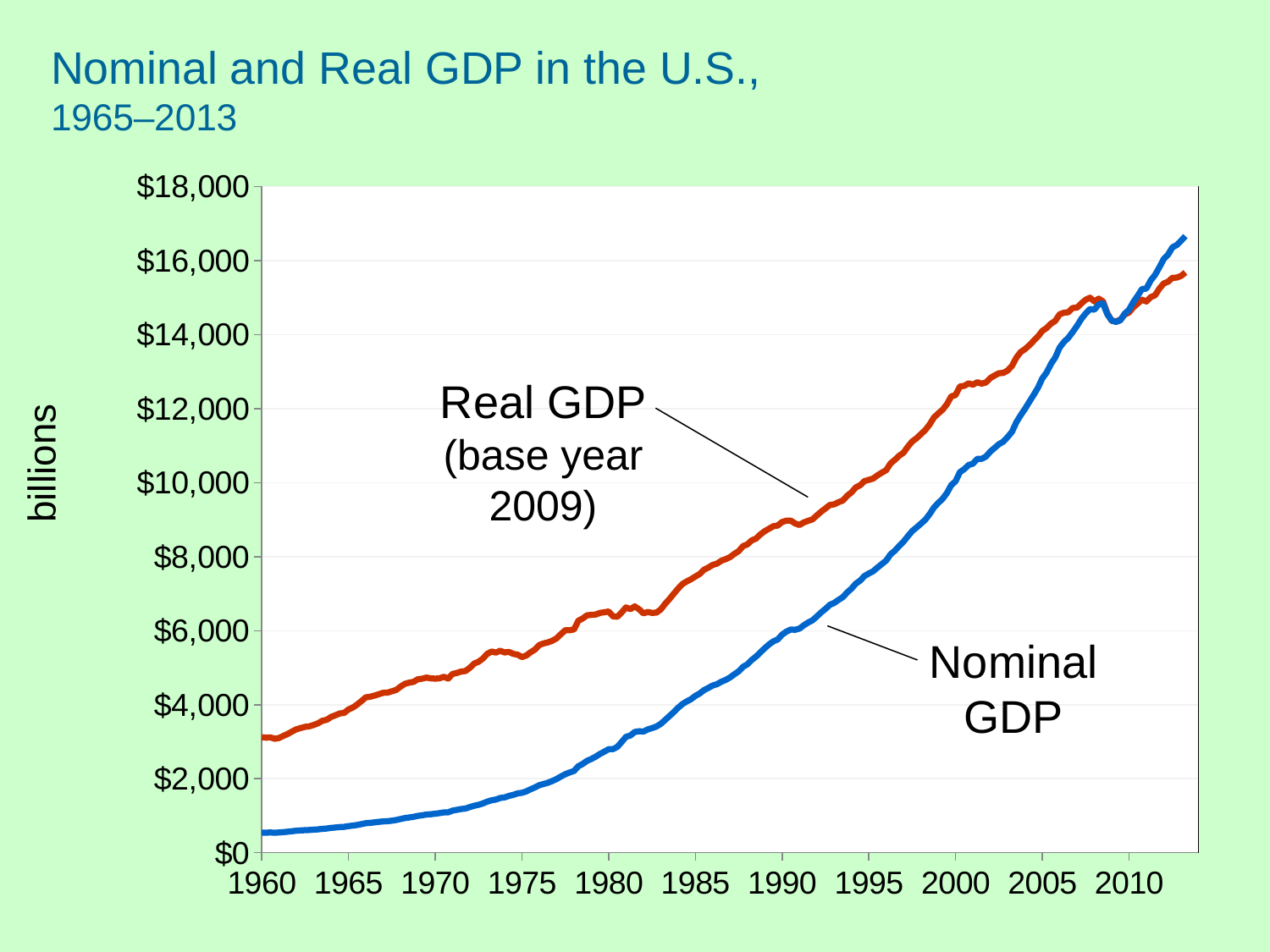
In 1990, which is higher: Real GDP or Nominal GDP? Real GDP What kind of chart is shown on the slide? line chart Is the value of Real GDP in 1960 greater or less than $2,000? greater Is the value of Nominal GDP in 1960 greater or less than $2,000? less At the end of the series in 2013, which is higher: Nominal GDP or Real GDP? Nominal GDP What is the label on the vertical axis of the chart? billions Is the value of Nominal GDP in 2005 greater or less than $12,000? greater In 1960, which is higher: Real GDP or Nominal GDP? Real GDP Does Nominal GDP generally rise or fall from 1960 to 2013? rise What is the title of the chart on the slide? Nominal and Real GDP in the U.S., 1965–2013 How many series are plotted on the chart? 2